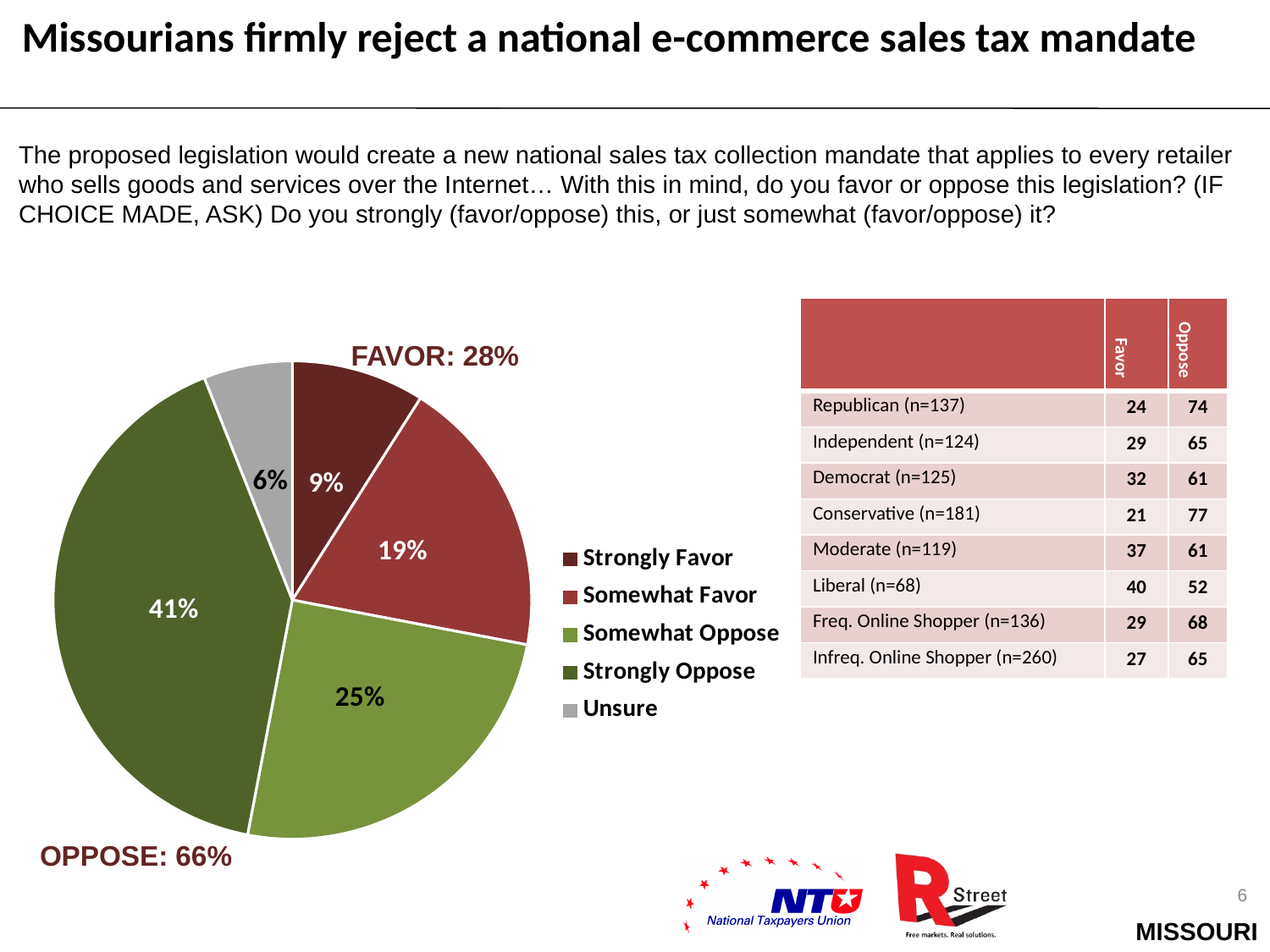
How many entries does the pie chart legend list? 5 Which response category has the largest share of the pie? Strongly Oppose What percentage of respondents said they Strongly Favor the legislation? 9% What total is shown for OPPOSE next to the pie chart? 66% Which is larger, the Somewhat Favor share or the Somewhat Oppose share? Somewhat Oppose What is the difference between the Strongly Oppose and Somewhat Oppose shares? 16% How many slices does the pie chart have? 5 What kind of chart is shown on the slide? Pie chart What percentage of respondents said they Somewhat Favor the legislation? 19% What percentage of respondents said they Strongly Oppose the legislation? 41% Which response category has the smallest share of the pie? Unsure What percentage of respondents were Unsure? 6%